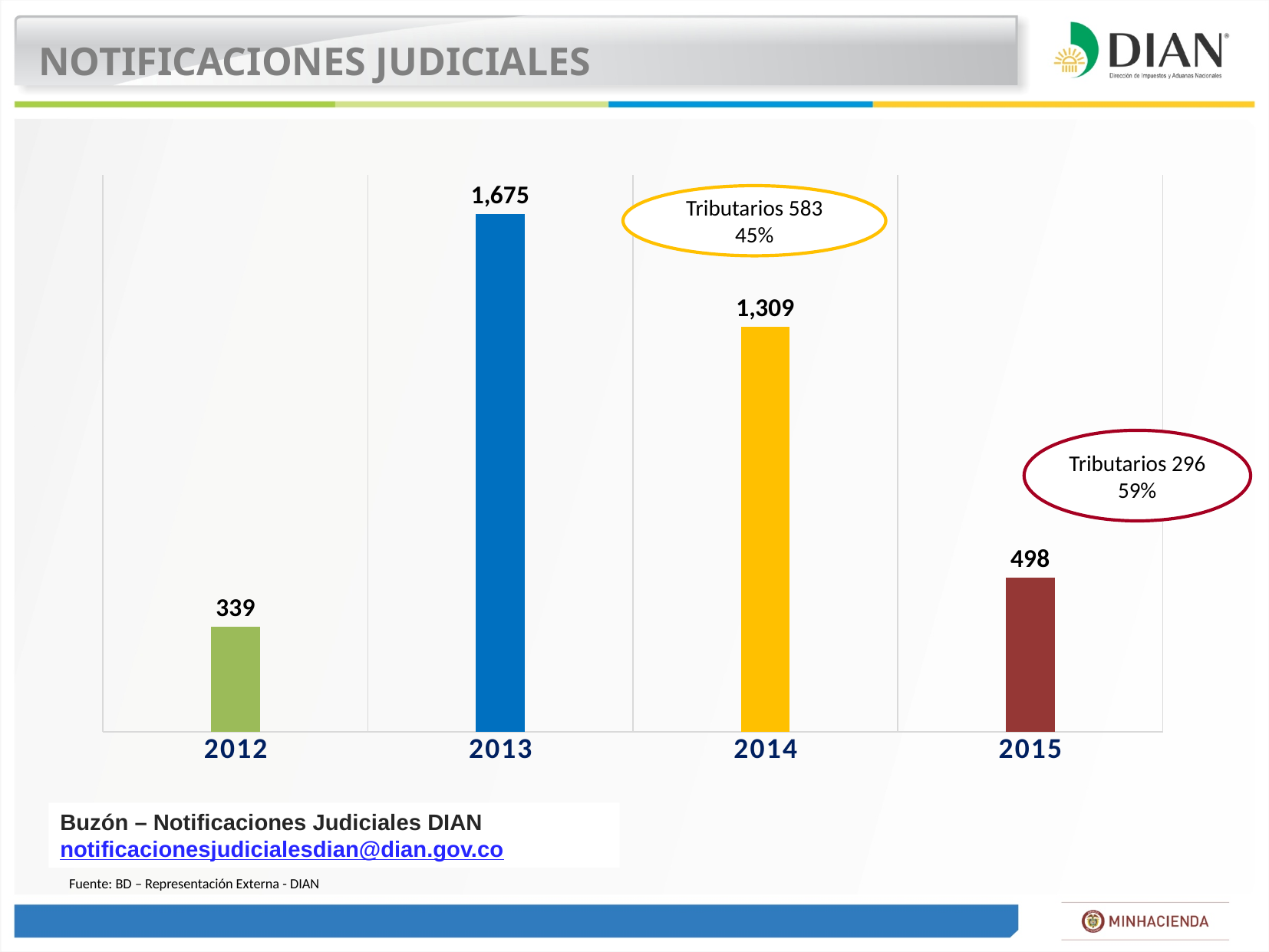
How many years are shown on the x axis? 4 What is the difference between the values for 2013 and 2014? 366 What kind of chart is shown on the slide? bar chart What is the value for 2013? 1,675 What is the value for 2012? 339 Which year has the highest value? 2013 What is the difference between the values for 2015 and 2012? 159 Do the values rise or fall from 2013 to 2015? fall What is the value for 2015? 498 What is the title of the slide containing the chart? NOTIFICACIONES JUDICIALES Which year has the lowest value? 2012 Which is larger, the value for 2014 or the value for 2015? 2014